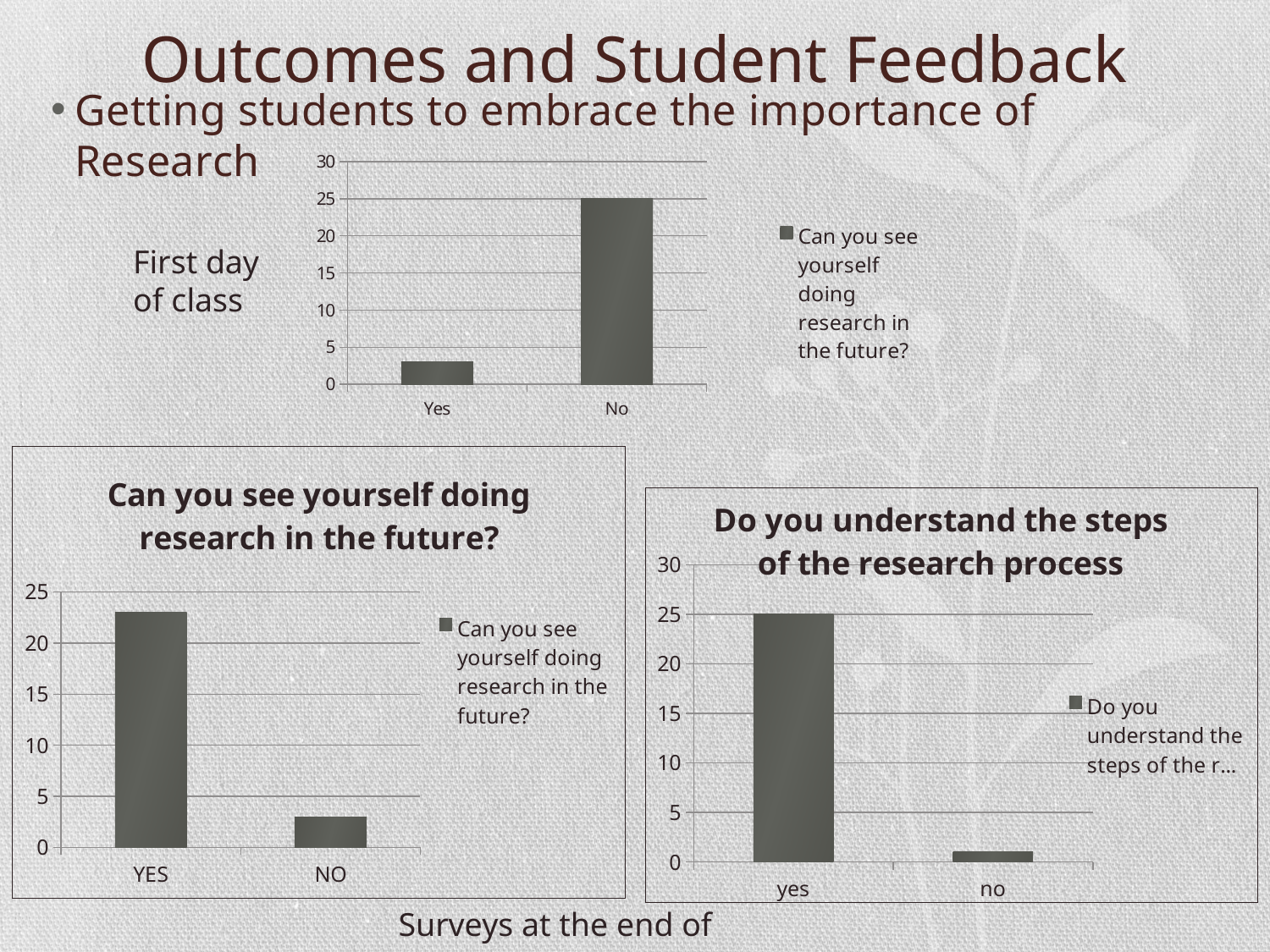
In the top chart (first day of class), what is the value for No? 25 In the chart titled 'Can you see yourself doing research in the future?' (bottom left), is the value for YES greater or less than 20? greater How many series does the legend list in the chart titled 'Can you see yourself doing research in the future?' (bottom left)? 1 In the top chart (first day of class), is the value for Yes greater or less than 5? less In the chart titled 'Do you understand the steps of the research process' (bottom right), what is the value for yes? 25 In the chart titled 'Can you see yourself doing research in the future?' (bottom left), which category is highest? YES In the top chart (first day of class), how many categories are shown on the x axis? 2 In the chart titled 'Do you understand the steps of the research process' (bottom right), which category is lowest? no In the top chart (first day of class), which category is highest? No In the chart titled 'Do you understand the steps of the research process' (bottom right), is the value for no greater or less than 5? less What kind of chart is the chart titled 'Do you understand the steps of the research process' (bottom right)? bar chart